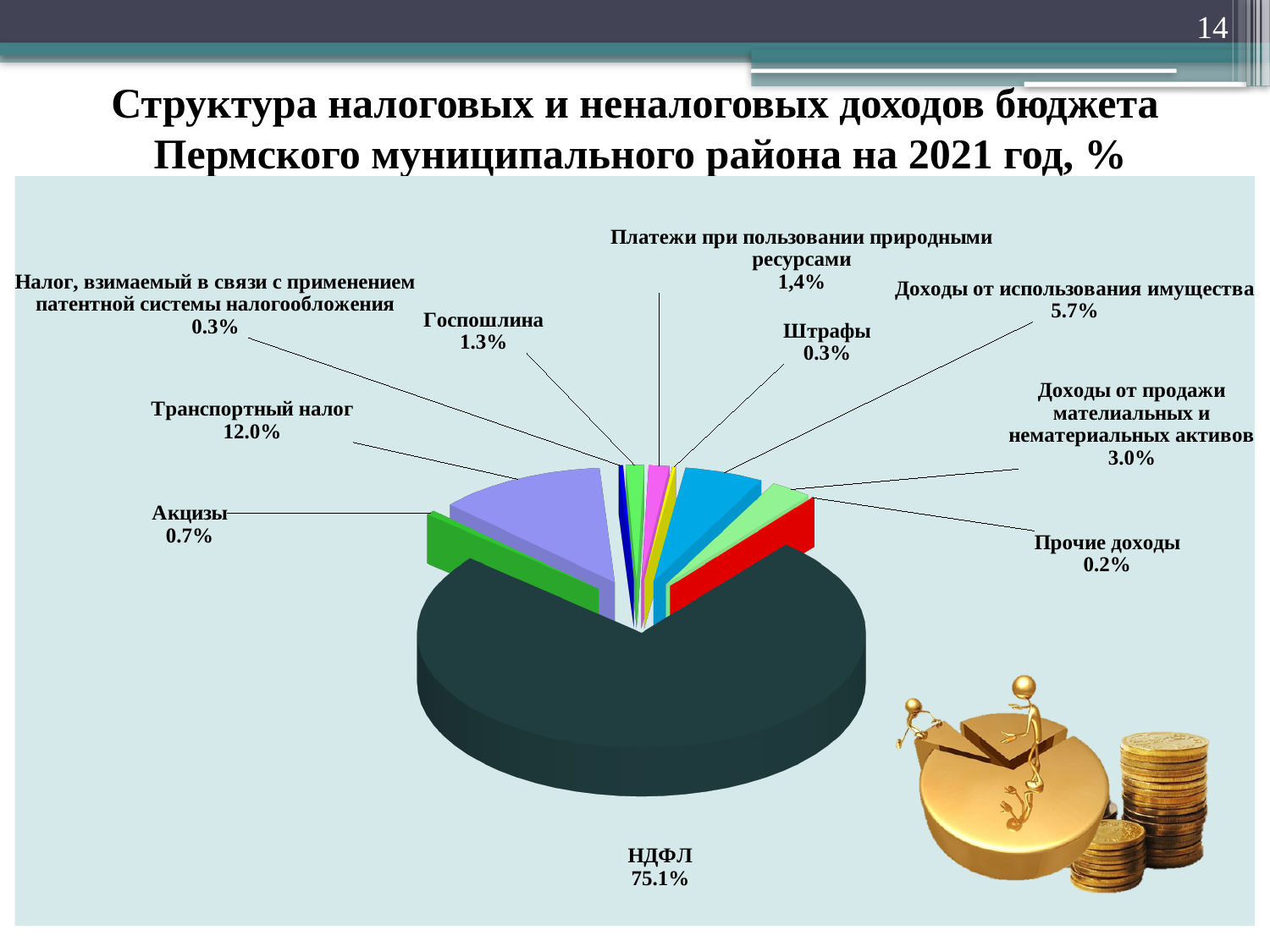
Which category has the largest share of the pie? НДФЛ What is the value shown for Транспортный налог? 12.0% Which category has the smallest share of the pie? Прочие доходы How many categories (slices) does the pie chart have? 10 What type of chart is shown on the slide? pie chart What is the difference in percentage points between НДФЛ and Транспортный налог? 63.1 What is the value shown for Доходы от использования имущества? 5.7% What share of the budget revenue does НДФЛ account for? 75.1% What is the value shown for Госпошлина? 1.3% Which is larger: Доходы от использования имущества or Доходы от продажи мателиальных и нематериальных активов? Доходы от использования имущества What is the value shown for Акцизы? 0.7% What year does the chart title refer to? 2021